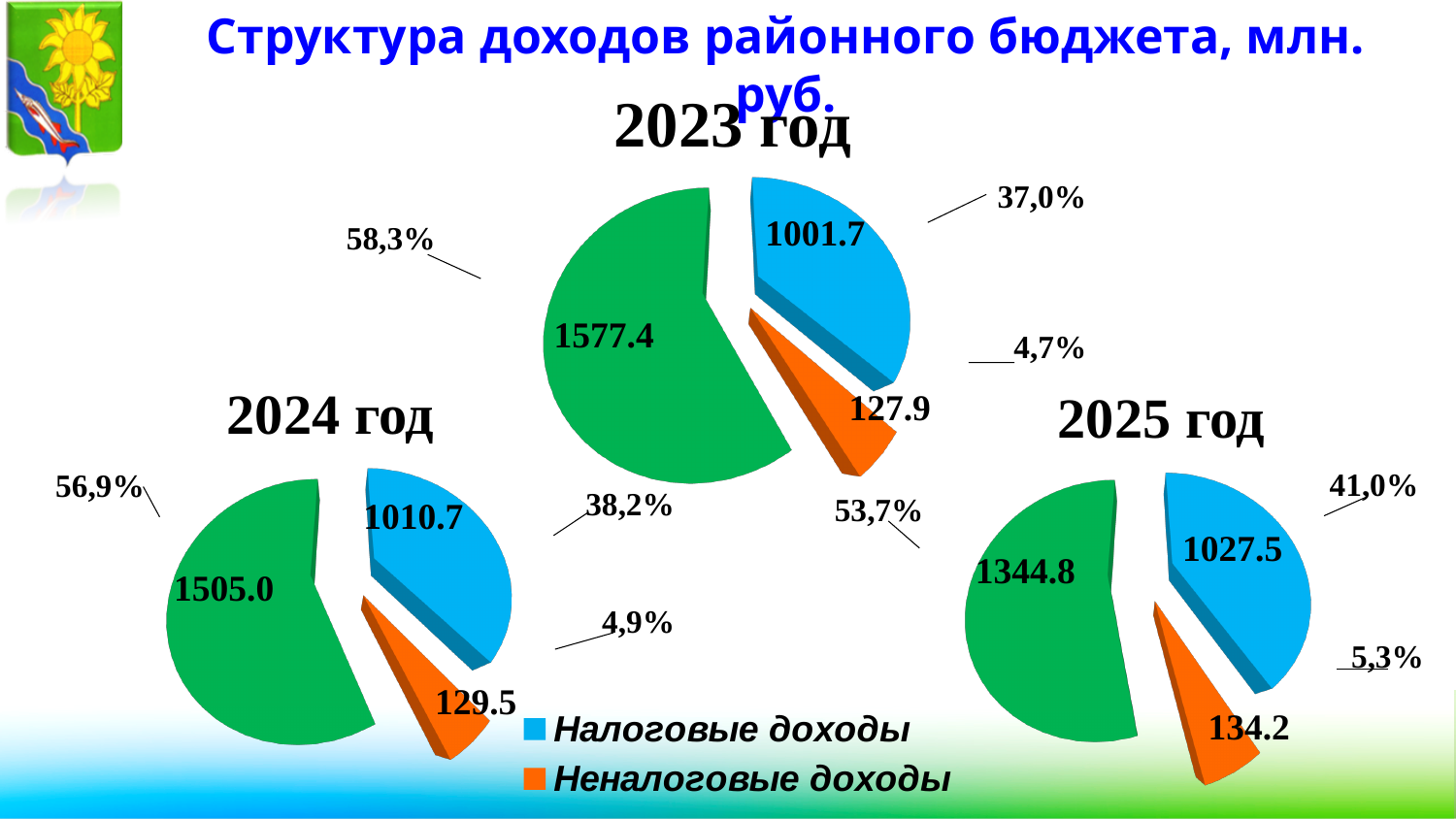
How many pie charts are on the slide? 3 What kind of charts are shown on the slide? Pie charts In the 2025 год pie chart, what is the value for Неналоговые доходы? 134.2 In the 2025 год pie chart, what is the value of the largest slice? 1344.8 In the 2023 год pie chart, what share of the pie is Неналоговые доходы? 4,7% In the 2024 год pie chart, which slice is the smallest? Неналоговые доходы How many series does the legend list? 2 Which chart shows a larger value for Налоговые доходы, 2023 год or 2025 год? 2025 год In the 2024 год pie chart, what share of the pie is Налоговые доходы? 38,2% In the 2025 год pie chart, what share of the pie is Неналоговые доходы? 5,3% In the 2023 год pie chart, what is the value for Налоговые доходы? 1001.7 In the 2025 год pie chart, what is the difference between Налоговые доходы and Неналоговые доходы? 893.3